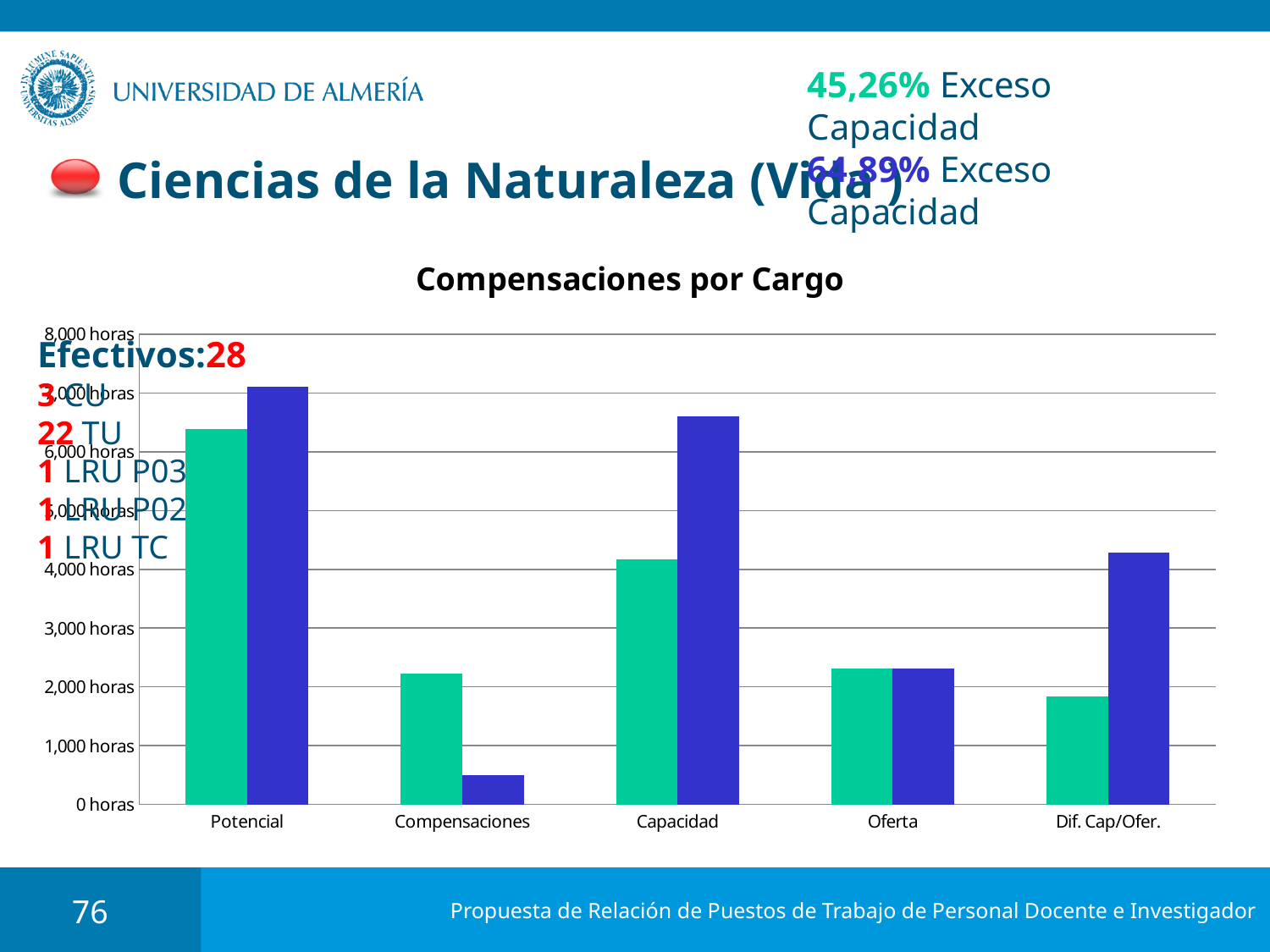
What is the title of the chart on the slide? Compensaciones por Cargo Is the blue bar for Capacidad greater or less than 6,000 horas? greater Is the green bar for Potencial greater or less than 6,000 horas? greater Is the green bar for Dif. Cap/Ofer. greater or less than 2,000 horas? less What type of chart is shown under the title 'Compensaciones por Cargo'? bar chart How many categories are shown on the x axis of the 'Compensaciones por Cargo' chart? 5 Which category has the shortest blue bar in the chart? Compensaciones For the Capacidad category, which bar is taller, the green one or the blue one? the blue one For the Compensaciones category, which bar is taller, the green one or the blue one? the green one What unit is shown on the y axis of the chart? horas Which category has the tallest green bar in the chart? Potencial